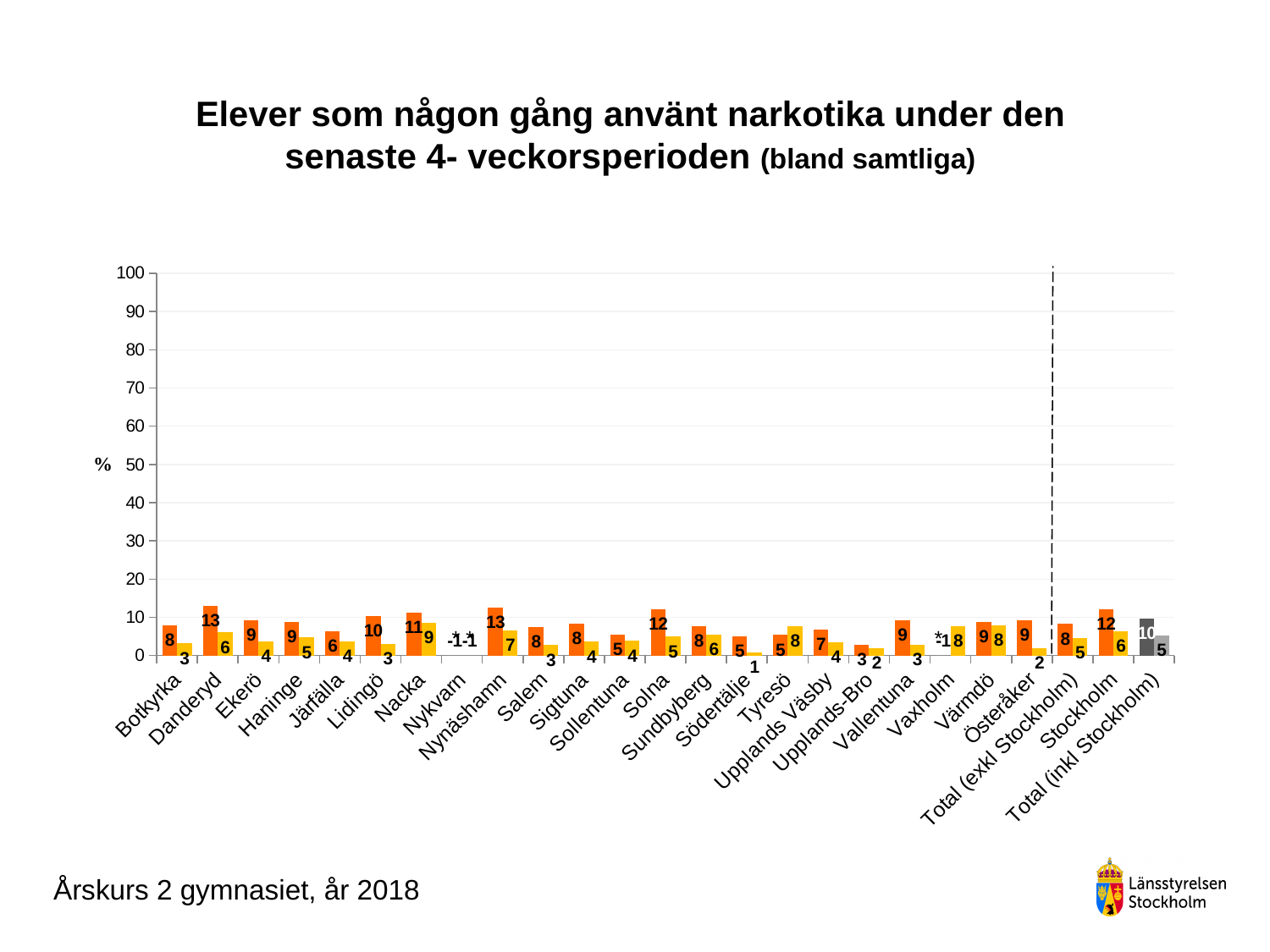
What is the value of the yellow bar for Södertälje? 1 Which category has the highest yellow bar? Nacka What is the title of the chart? Elever som någon gång använt narkotika under den senaste 4- veckorsperioden (bland samtliga) How many categories are shown on the x axis? 25 What are the two values shown for Total (inkl Stockholm)? 10 and 5 What is the value of the yellow bar for Nacka? 9 What kind of chart is shown on the slide? bar chart What is the difference between the orange and yellow bars for Solna? 7 Which has the larger orange bar, Lidingö or Nacka? Nacka What is the value of the orange bar for Stockholm? 12 Is the orange bar for Danderyd greater or less than 20? less What is the value of the orange bar for Danderyd? 13